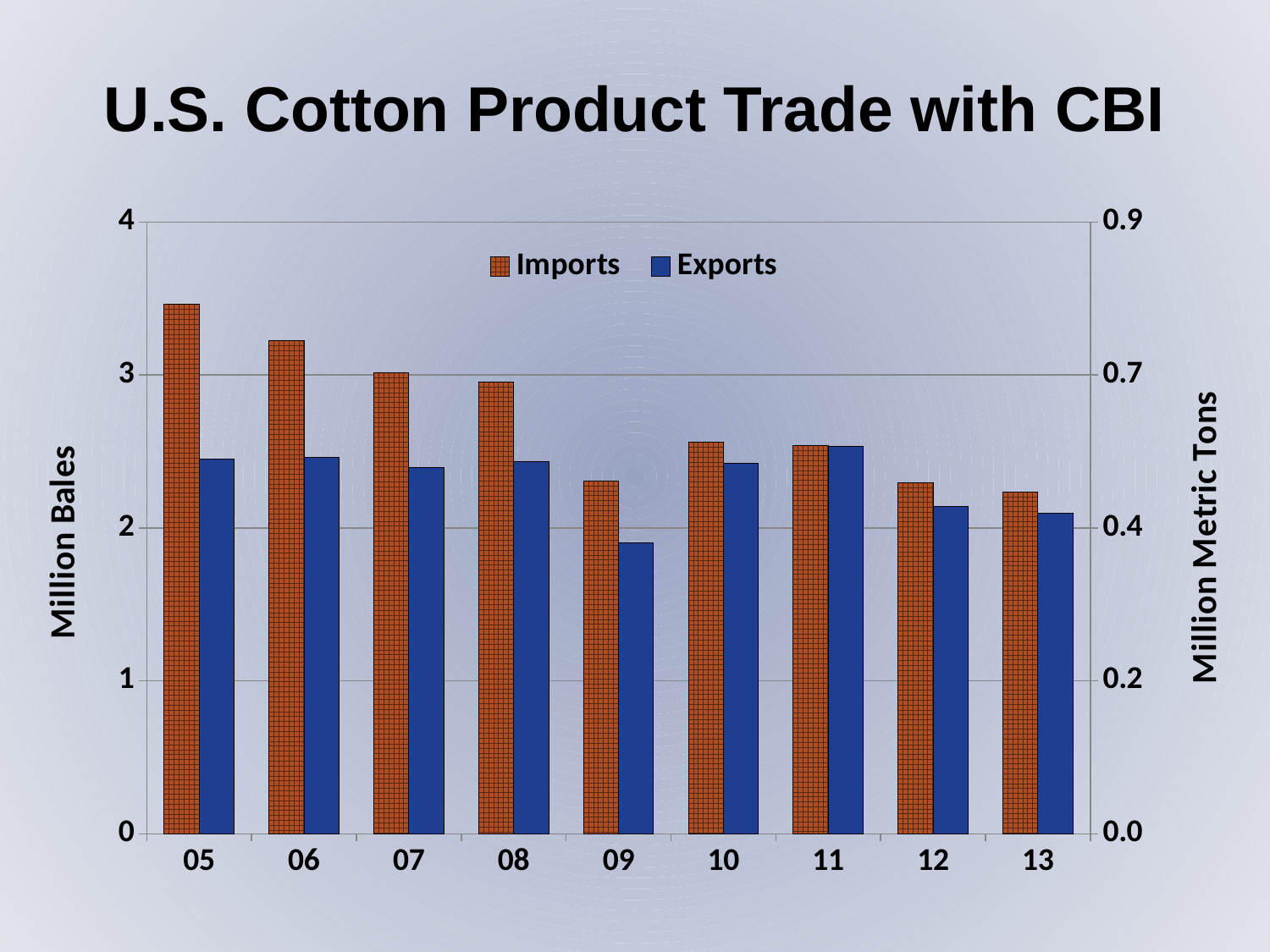
What is the label on the right-hand vertical axis? Million Metric Tons How many years are shown on the x axis? 9 Which year has the highest Imports value? 05 Do the Imports values generally rise or fall from 05 to 13? fall In 09, which is larger, Imports or Exports? Imports Is the Exports value for 09 greater or less than 2 on the left axis? less How many series does the legend list? 2 Which year has the lowest Exports value? 09 In 05, which is larger, Imports or Exports? Imports Is the Imports value for 05 greater or less than 3 million bales? greater What kind of chart is shown on the slide? bar chart Is the Imports value for 06 greater or less than 3 on the left axis? greater